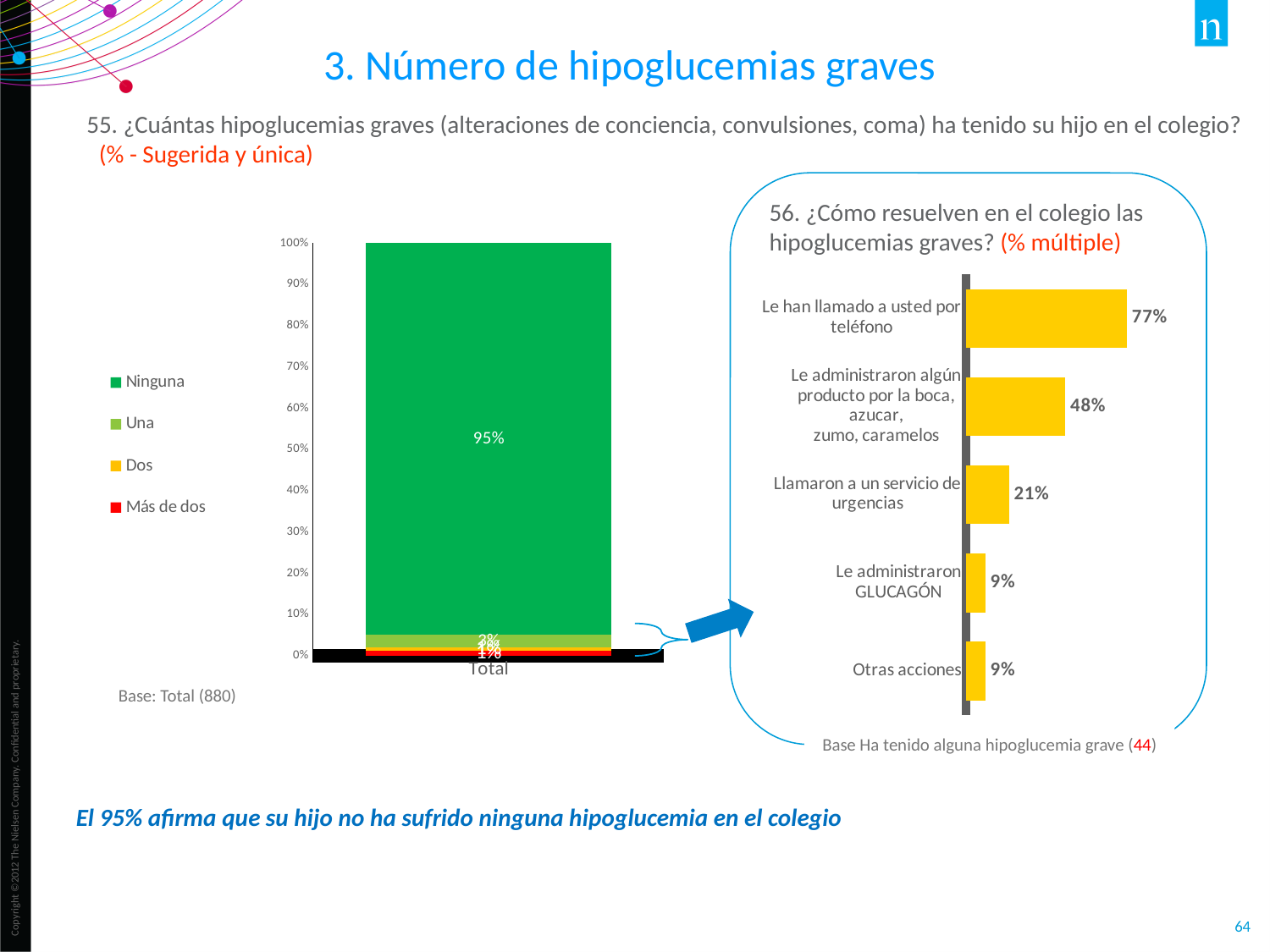
In the left-hand chart (question 55), is the value for 'Ninguna' greater or less than 90%? greater In the left-hand stacked bar chart (question 55), what percentage is shown for 'Ninguna'? 95% In the right-hand chart (question 56), what percentage is shown for 'Le administraron GLUCAGÓN'? 9% How many categories are shown in the right-hand chart (question 56)? 5 In the right-hand chart (question 56), which category has the highest value? Le han llamado a usted por teléfono What kind of chart is the right-hand chart (question 56)? Bar chart In the right-hand chart (question 56), what percentage is shown for 'Llamaron a un servicio de urgencias'? 21% In the right-hand chart (question 56), which is larger: 'Le administraron algún producto por la boca, azucar, zumo, caramelos' or 'Llamaron a un servicio de urgencias'? Le administraron algún producto por la boca, azucar, zumo, caramelos How many series does the legend of the left-hand chart (question 55) list? 4 In the right-hand chart (question 56), what is the difference between 'Le han llamado a usted por teléfono' and 'Le administraron algún producto por la boca, azucar, zumo, caramelos'? 29% In the left-hand chart (question 55), what colour represents 'Ninguna' in the legend? Green In the right-hand chart (question 56), what percentage is shown for 'Le han llamado a usted por teléfono'? 77%